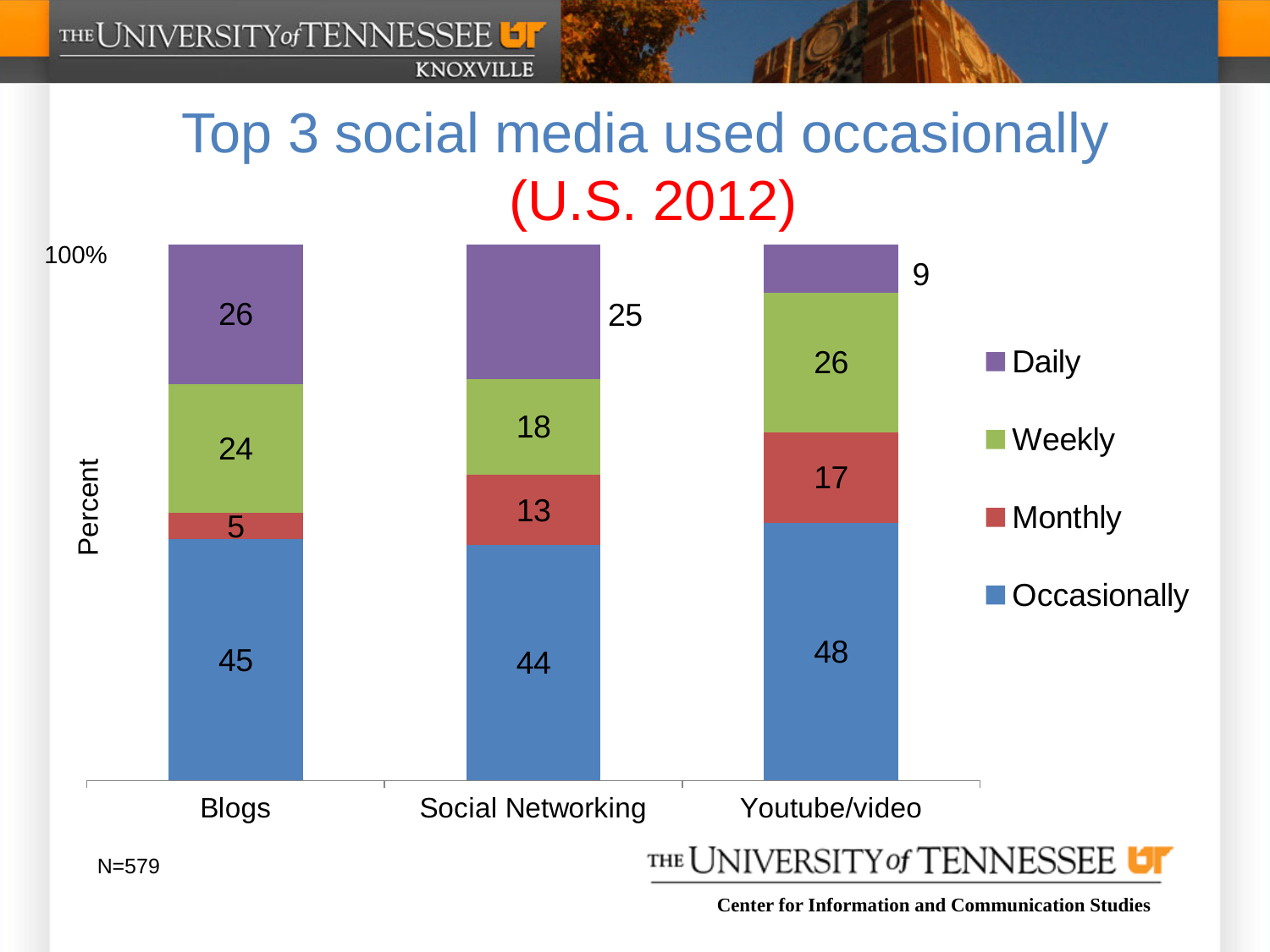
What is the total of the stacked bar for Social Networking? 100 What is the Occasionally value for Youtube/video? 48 How many series does the legend list? 4 What is the Daily value for Social Networking? 25 How many categories are shown on the x axis? 3 Which category has the lowest Daily value? Youtube/video What kind of chart is shown on the slide? Stacked bar chart What is the Weekly value for Youtube/video? 26 What is the Monthly value for Blogs? 5 What is the difference between the Monthly values for Youtube/video and Blogs? 12 Which is larger, the Weekly value for Blogs or the Weekly value for Social Networking? Blogs Which category has the highest Occasionally value? Youtube/video